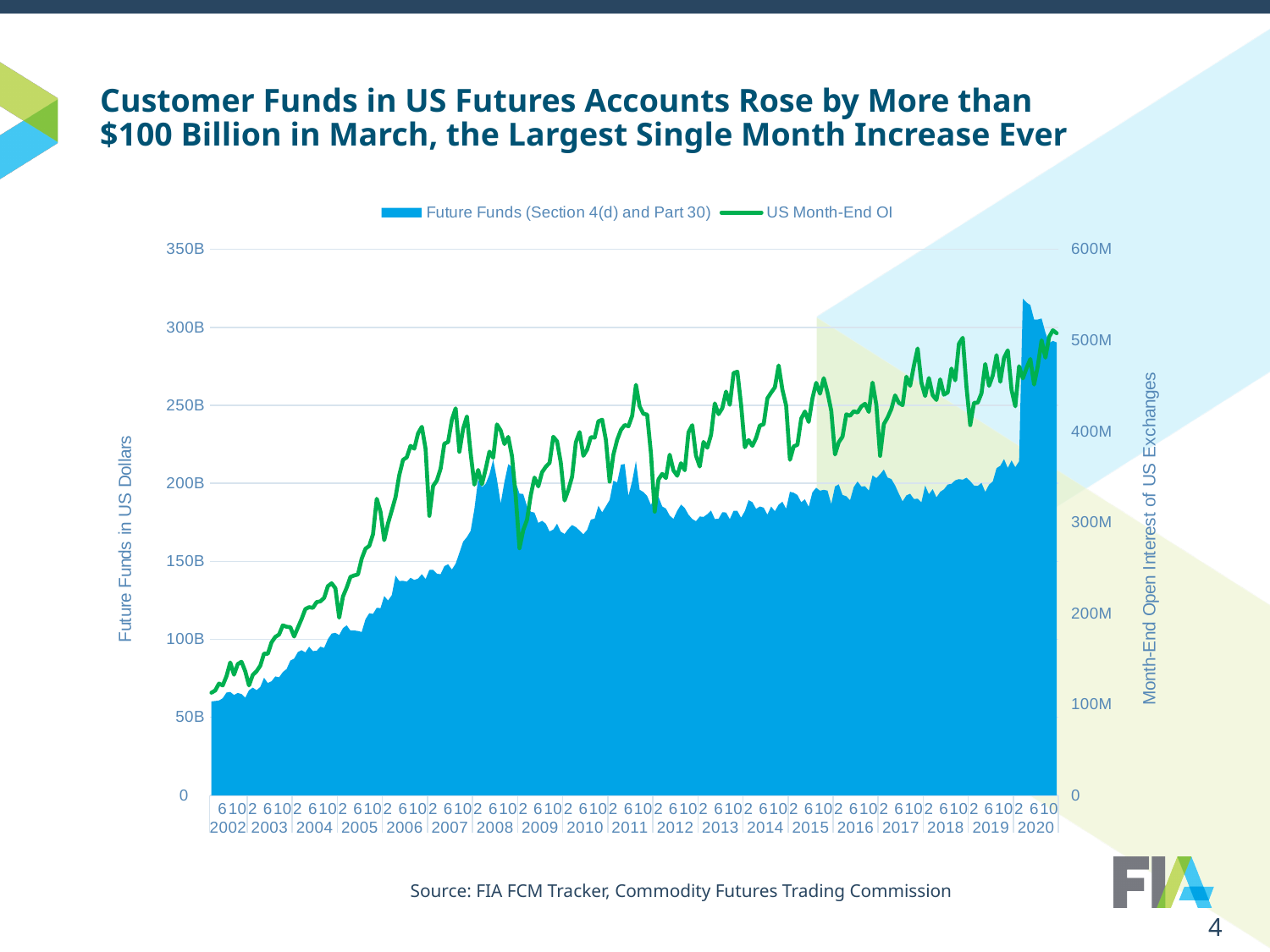
In which year are Future Funds at their lowest level? 2002 What kind of chart is shown on the slide? An area chart combined with a line chart Is the peak value of Future Funds in 2020 greater or less than 300B? greater How many years are labelled on the x axis of the chart? 19 What is the overall trend of US Month-End OI from 2002 to 2020? Rising How many series does the chart legend list? 2 Is the value of US Month-End OI at the start of 2002 greater or less than 200M? less Is the value of US Month-End OI at the end of 2020 greater or less than 400M? greater What is the title of the right-hand vertical axis? Month-End Open Interest of US Exchanges What is the overall trend of Future Funds from 2002 to 2020? Rising In which year do Future Funds reach their highest level? 2020